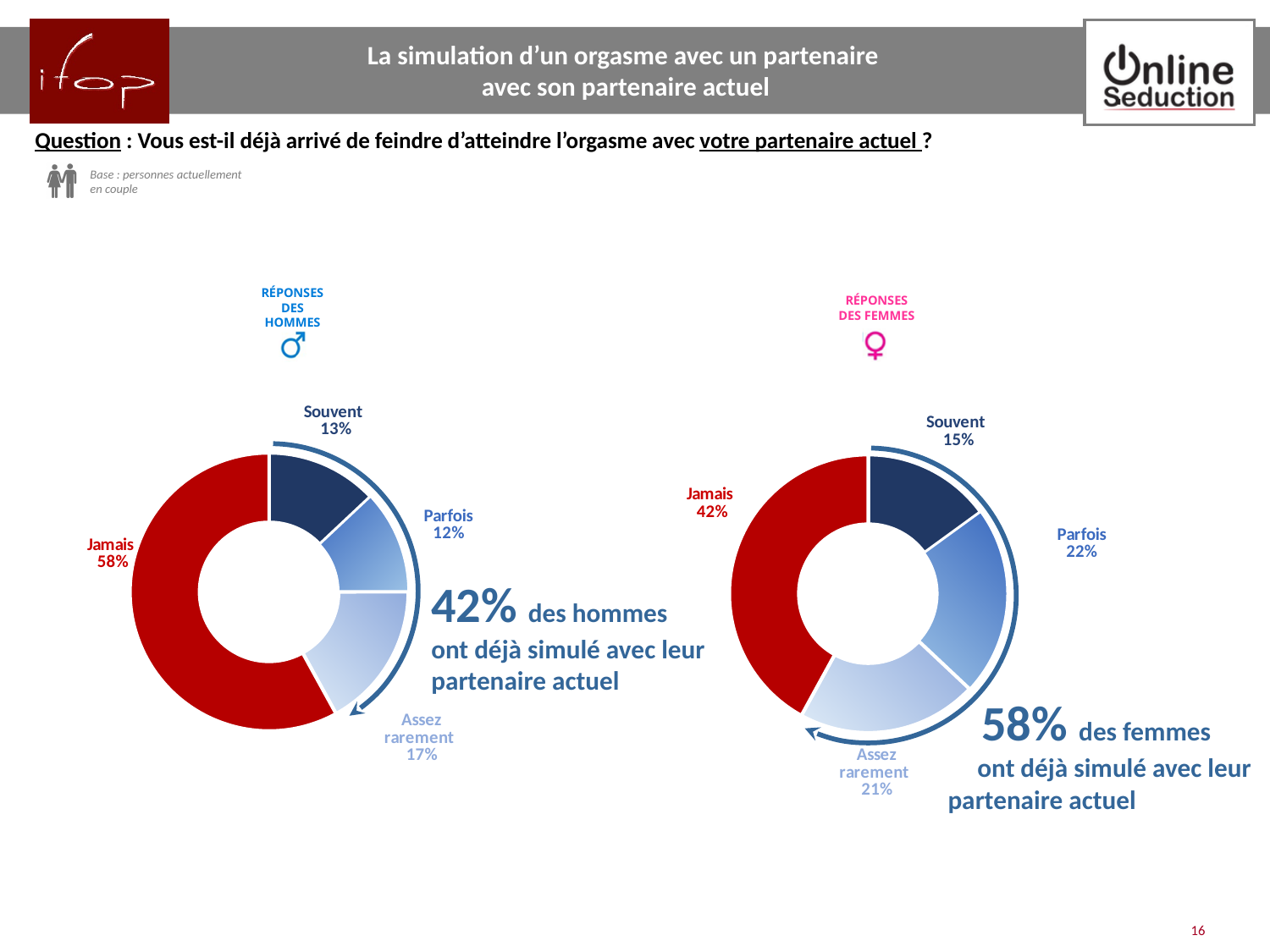
What is the difference between the "Jamais" share in the left chart (hommes) and the "Jamais" share in the right chart (femmes)? 16 percentage points In the left chart (Réponses des hommes), what percentage of men answered "Jamais"? 58% Which is larger: the "Parfois" share for men in the left chart or the "Parfois" share for women in the right chart? Women (22%) What type of chart is used on this slide to show the responses? Donut (pie) chart According to the text next to the right chart, what percentage of women have already simulated an orgasm with their current partner? 58% In the right chart (Réponses des femmes), what percentage of women answered "Parfois"? 22% In the right chart (Réponses des femmes), what percentage of women answered "Assez rarement"? 21% In the left chart (Réponses des hommes), what percentage of men answered "Souvent"? 13% In the right chart (Réponses des femmes), which response has the smallest share? Souvent In the left chart (Réponses des hommes), which response has the smallest share? Parfois How many response categories are shown in the right chart (Réponses des femmes)? 4 In the left chart (Réponses des hommes), which response has the largest share? Jamais